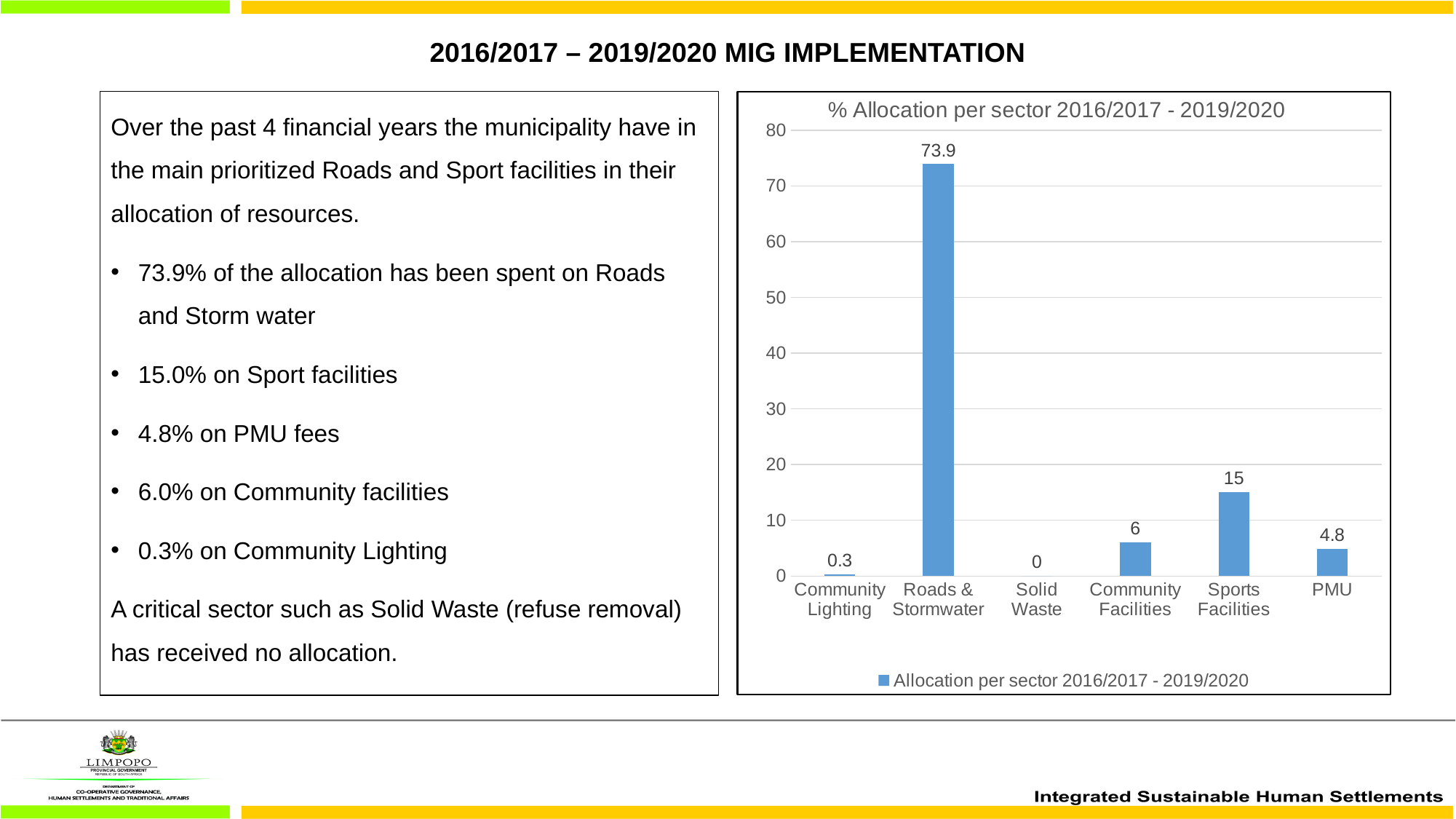
What kind of chart is shown? Bar chart What is the difference between the values for Roads & Stormwater and Sports Facilities? 58.9 Which sector has the highest allocation? Roads & Stormwater What is the value for Sports Facilities? 15 How many sectors are shown on the x axis? 6 What is the title of the chart? % Allocation per sector 2016/2017 - 2019/2020 Which is larger, the value for Community Facilities or the value for PMU? Community Facilities What is the value for Roads & Stormwater? 73.9 Which sector has the lowest allocation? Solid Waste What is the value for Community Lighting? 0.3 What is the value for PMU? 4.8 Is the value for Roads & Stormwater greater or less than 70? greater